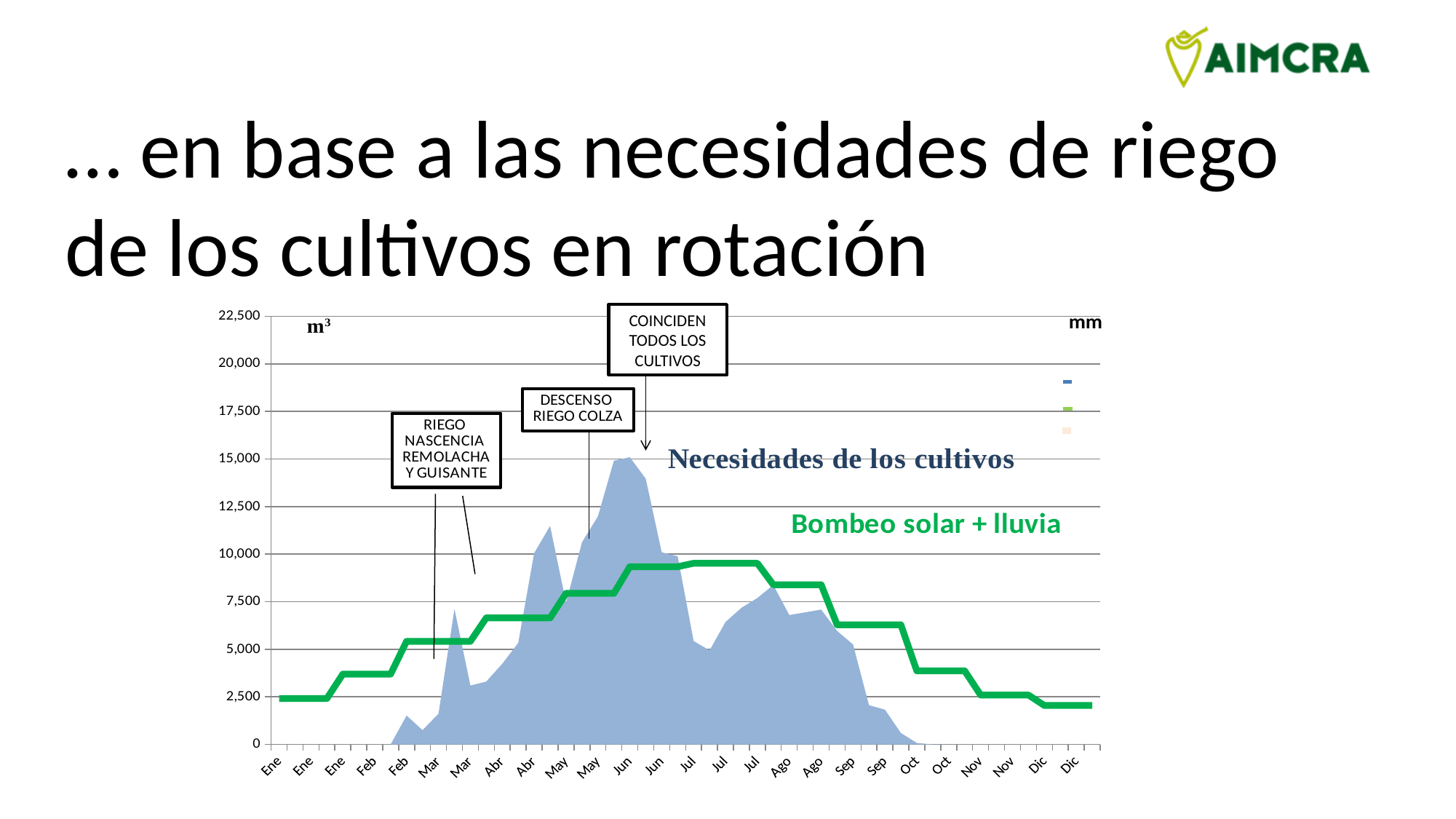
In which month does the 'Necesidades de los cultivos' area reach its peak? Jun Is the value of 'Bombeo solar + lluvia' at the first Ene point greater or less than 5,000? less Is the value of 'Necesidades de los cultivos' in Nov greater or less than 2,500? less Is the peak value of 'Necesidades de los cultivos' greater or less than 12,500? greater What is the highest value shown on the vertical axis? 22,500 Does the 'Bombeo solar + lluvia' line rise or fall from Ene to Jul? rise In Jun, which is larger: 'Necesidades de los cultivos' or 'Bombeo solar + lluvia'? Necesidades de los cultivos What kind of chart is shown on the slide? Area chart with a line series What colour is the 'Bombeo solar + lluvia' line? Green Does the 'Bombeo solar + lluvia' line rise or fall from Jul to Dic? fall At the first Ene point, which is larger: 'Necesidades de los cultivos' or 'Bombeo solar + lluvia'? Bombeo solar + lluvia